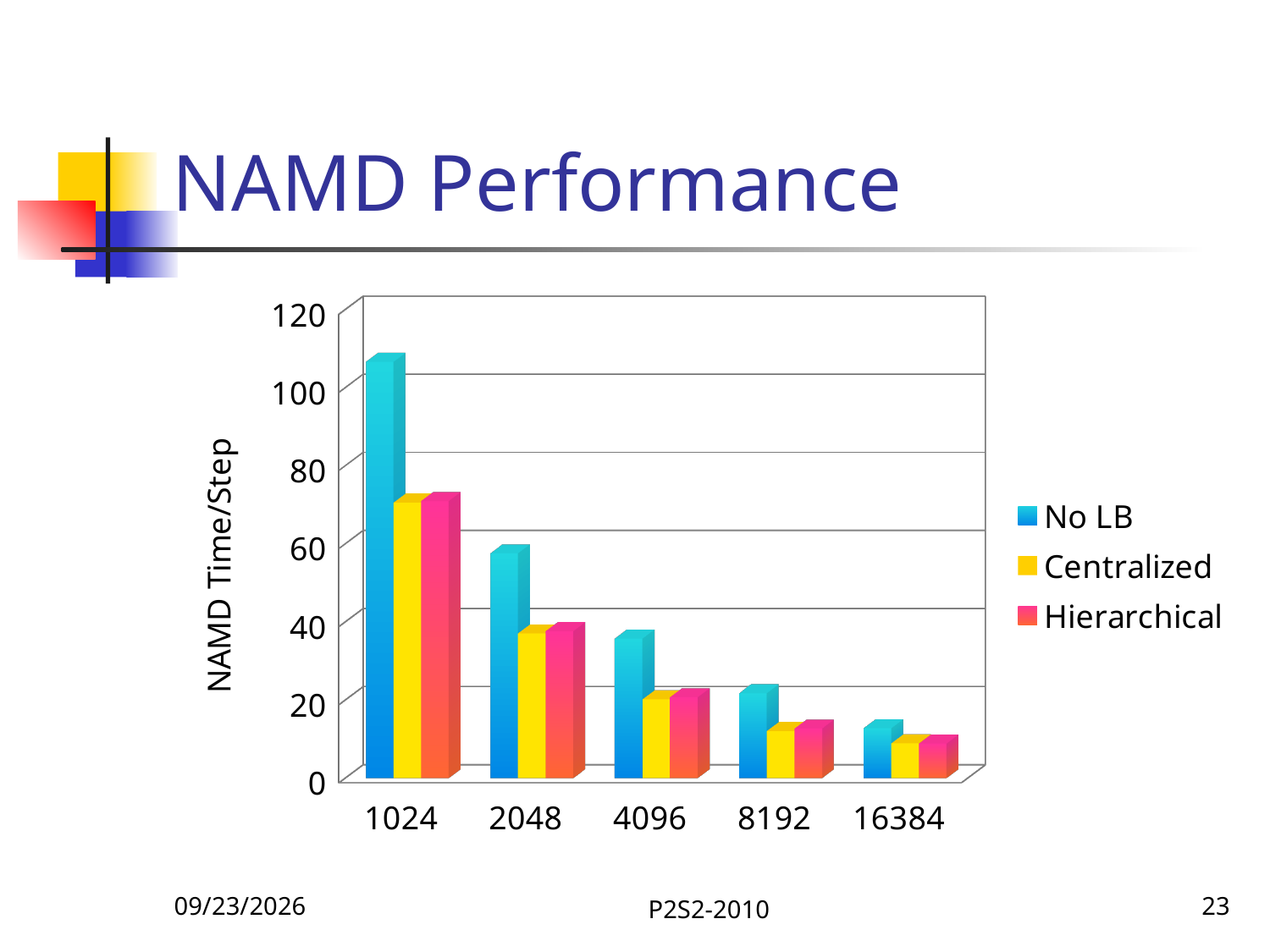
Is the Hierarchical value for 8192 greater or less than 20? less Which is larger at 2048, the No LB value or the Centralized value? No LB Do the No LB values rise or fall as the x-axis values increase from 1024 to 16384? fall Which category has the lowest No LB value? 16384 Is the No LB value for 1024 greater or less than 100? greater Which category has the highest No LB value? 1024 What kind of chart is shown on the slide? bar chart Is the Centralized value for 1024 greater or less than 60? greater How many series does the legend list? 3 How many categories are shown on the x axis? 5 What is the label of the vertical axis? NAMD Time/Step